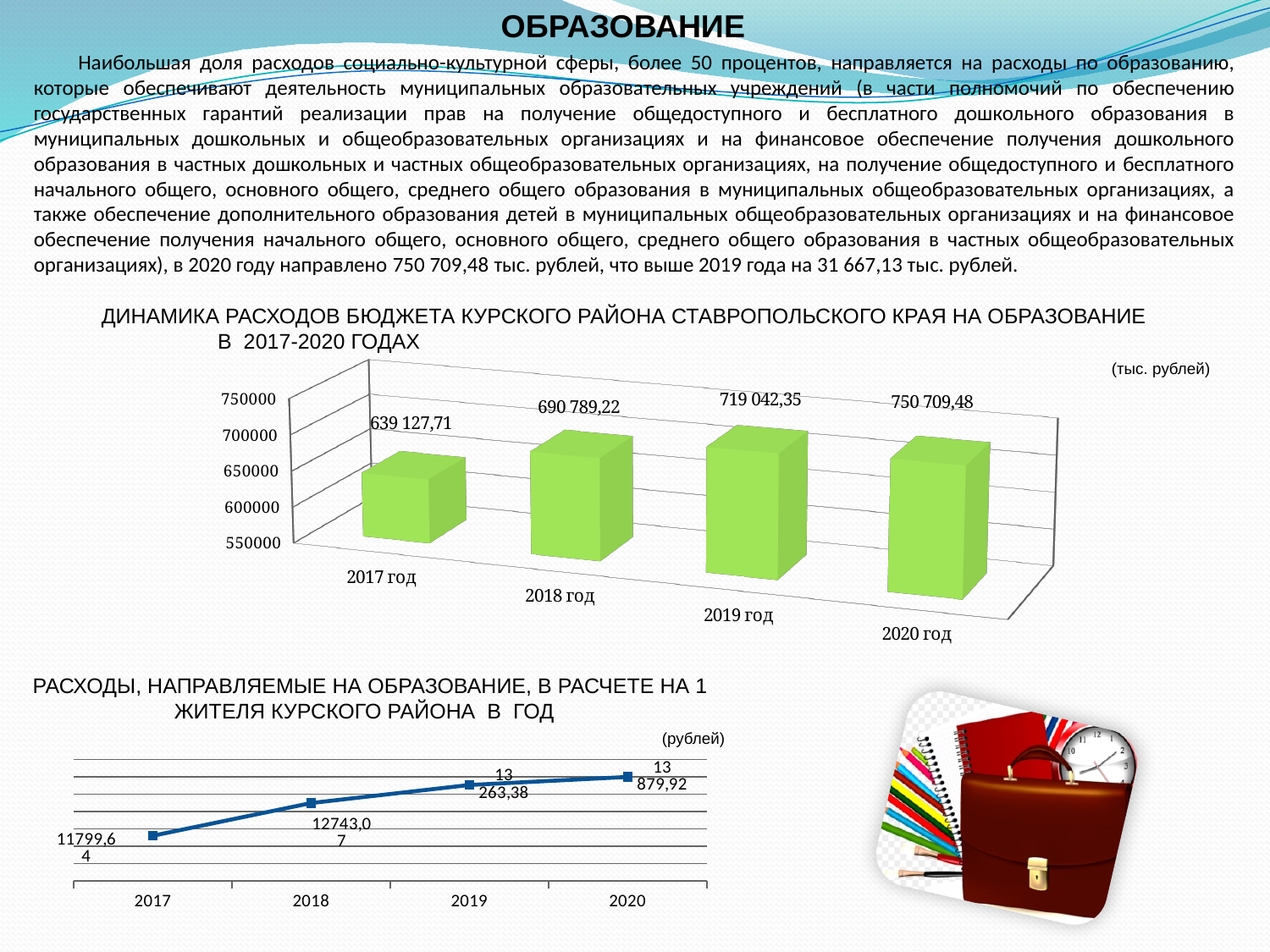
What kind of chart is the top chart on the slide (dynamics of education expenditures)? bar chart On the bottom line chart (expenditures per resident), what unit is indicated above the chart? (рублей) On the bottom line chart (expenditures per resident), what is the value for 2019? 13 263,38 On the top bar chart (dynamics of education expenditures), what is the value for 2017 год? 639 127,71 On the bottom line chart (expenditures per resident), what is the value for 2020? 13 879,92 On the top bar chart (dynamics of education expenditures), do the values rise or fall from 2017 to 2020? rise On the top bar chart (dynamics of education expenditures), what is the difference between the values for 2020 год and 2019 год? 31 667,13 On the top bar chart (dynamics of education expenditures), what is the value for 2018 год? 690 789,22 On the top bar chart (dynamics of education expenditures), which year has the highest value? 2020 год On the top bar chart (dynamics of education expenditures), which year has the lowest value? 2017 год On the top bar chart (dynamics of education expenditures), how many years are shown? 4 On the top bar chart (dynamics of education expenditures), what is the value for 2020 год? 750 709,48